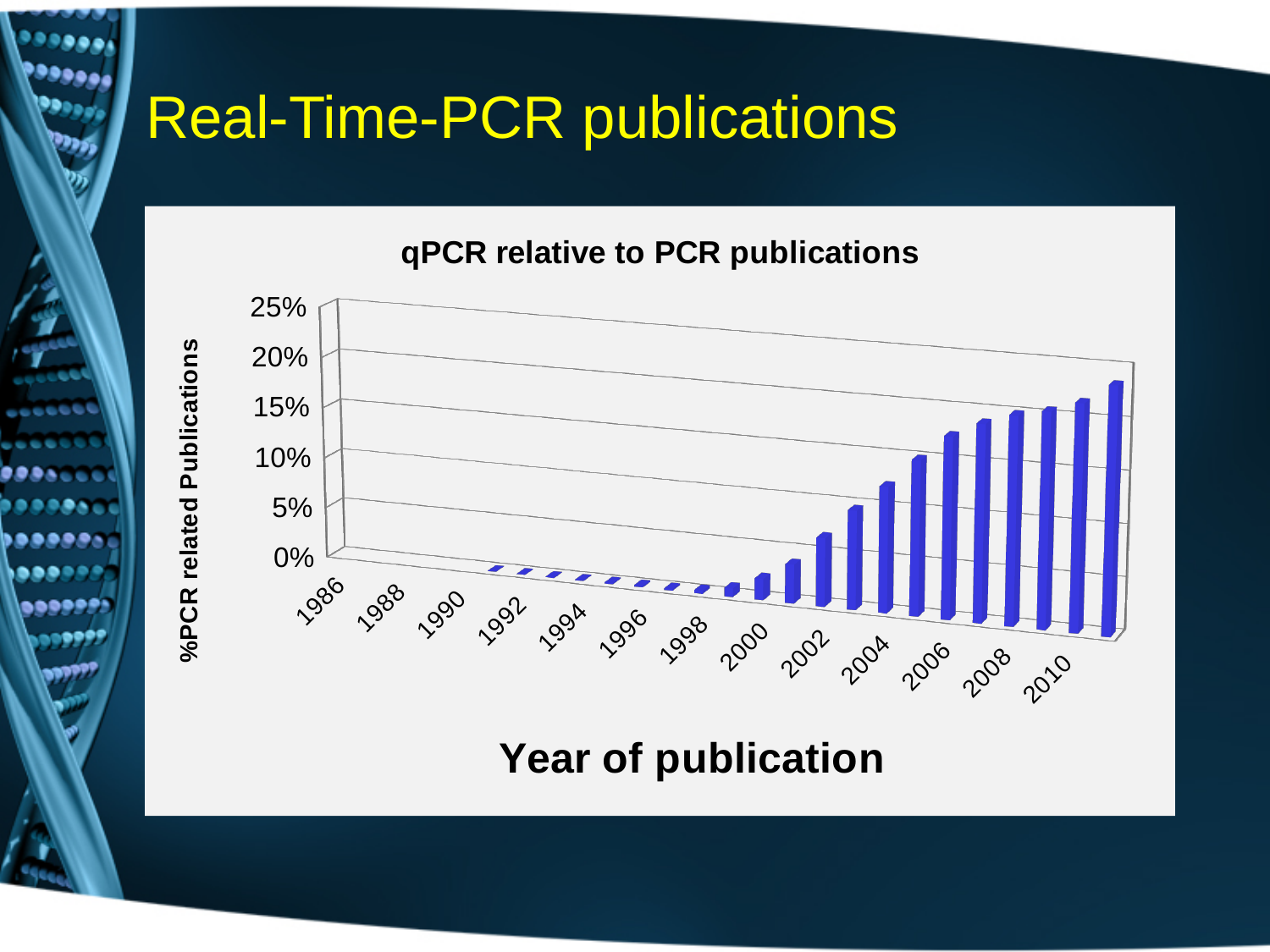
Is the value for 2000 greater or less than 5%? less How many year labels are shown on the x axis? 13 What is the title of the chart? qPCR relative to PCR publications Is the value for 2002 greater or less than 5%? greater Which is larger, the value for 2010 or the value for 2002? 2010 Is the value for 2006 greater or less than 10%? greater What is the label of the x axis? Year of publication What kind of chart is shown on the slide? Bar chart Do the values generally rise or fall from 1986 to 2010? Rise